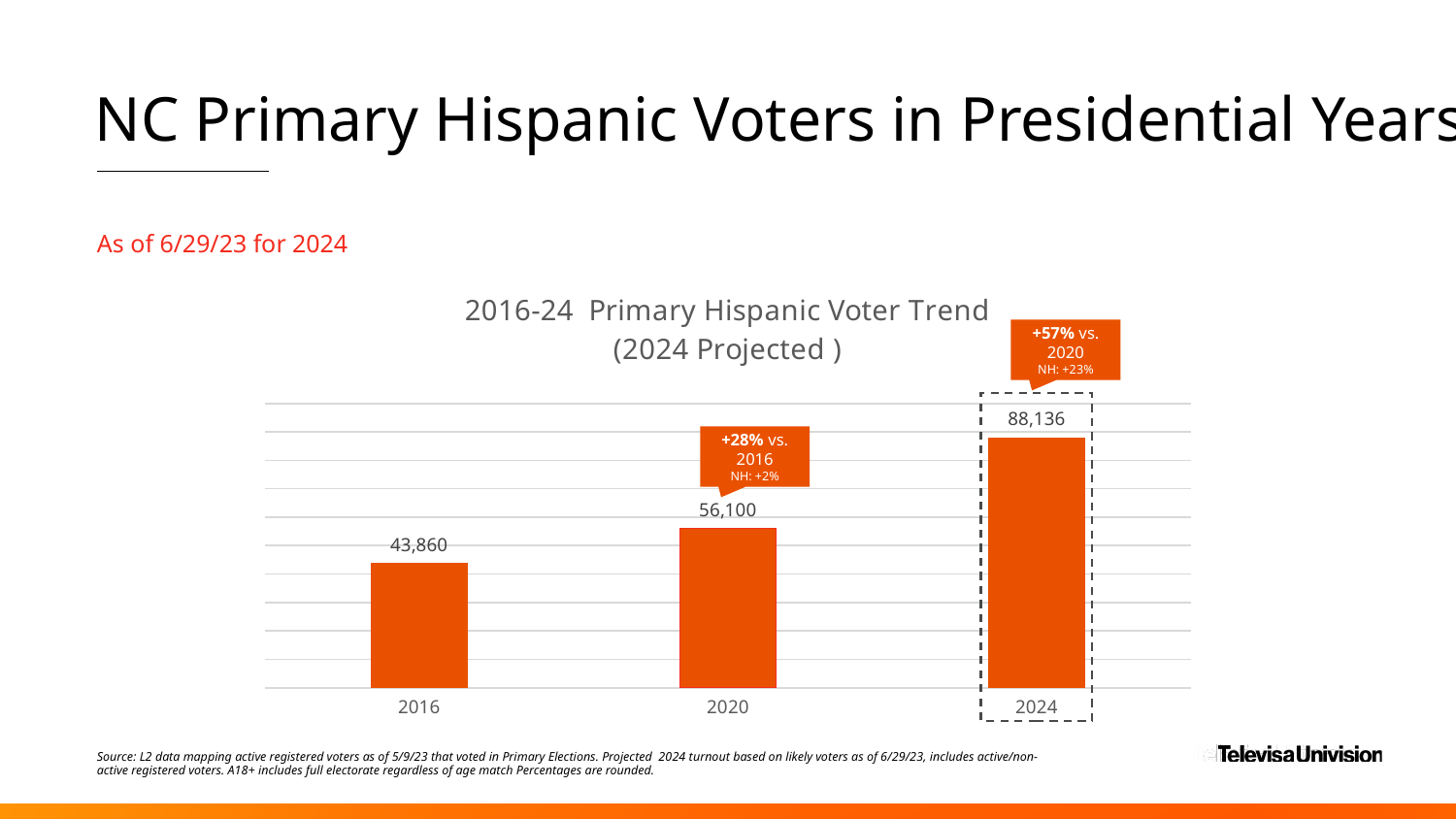
What is the difference between the 2024 and 2020 values? 32,036 What is the value for 2020? 56,100 Do the values rise or fall from 2016 to 2024? Rise What is the value for 2016? 43,860 How many years are plotted on the chart? 3 Which year has the lowest value? 2016 What is the projected value for 2024? 88,136 What is the title of the chart? 2016-24 Primary Hispanic Voter Trend (2024 Projected ) What kind of chart is shown? Bar chart Which year has the highest value? 2024 What is the difference between the 2020 and 2016 values? 12,240 Which is larger, the value for 2016 or the value for 2020? 2020